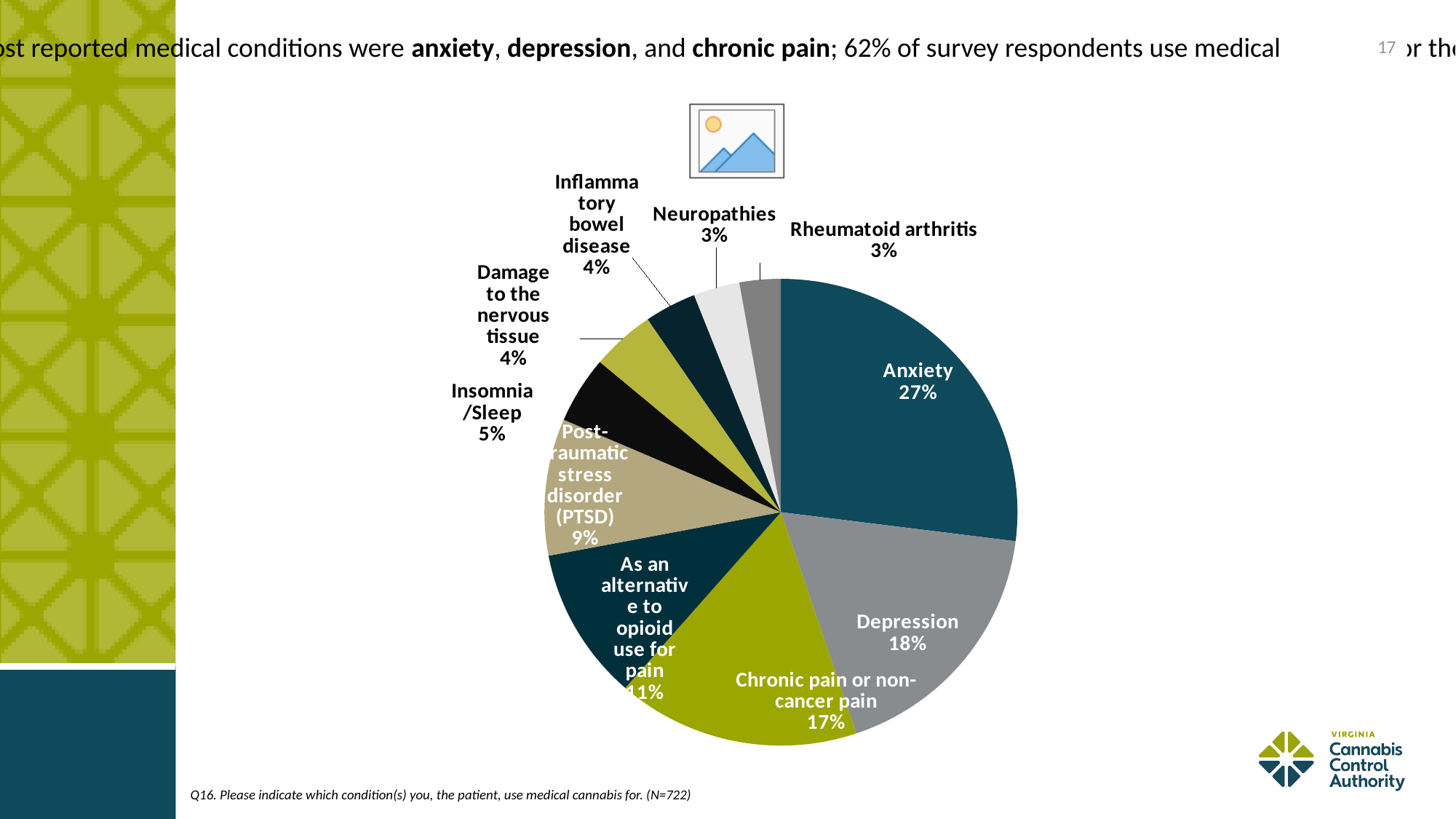
What percentage is shown for Chronic pain or non-cancer pain? 17% What share of the pie does Anxiety represent? 27% What kind of chart is shown on the slide? Pie chart What percentage is shown for Insomnia/Sleep? 5% Which is larger, the slice for Depression or the slice for Chronic pain or non-cancer pain? Depression What is the difference in percentage points between As an alternative to opioid use for pain and Post-traumatic stress disorder (PTSD)? 2 What is the difference in percentage points between Anxiety and Depression? 9 What percentage is shown for Neuropathies? 3% Which condition has the largest slice of the pie? Anxiety What percentage is shown for Post-traumatic stress disorder (PTSD)? 9% What percentage is shown for Depression? 18% How many slices does the pie chart have? 10